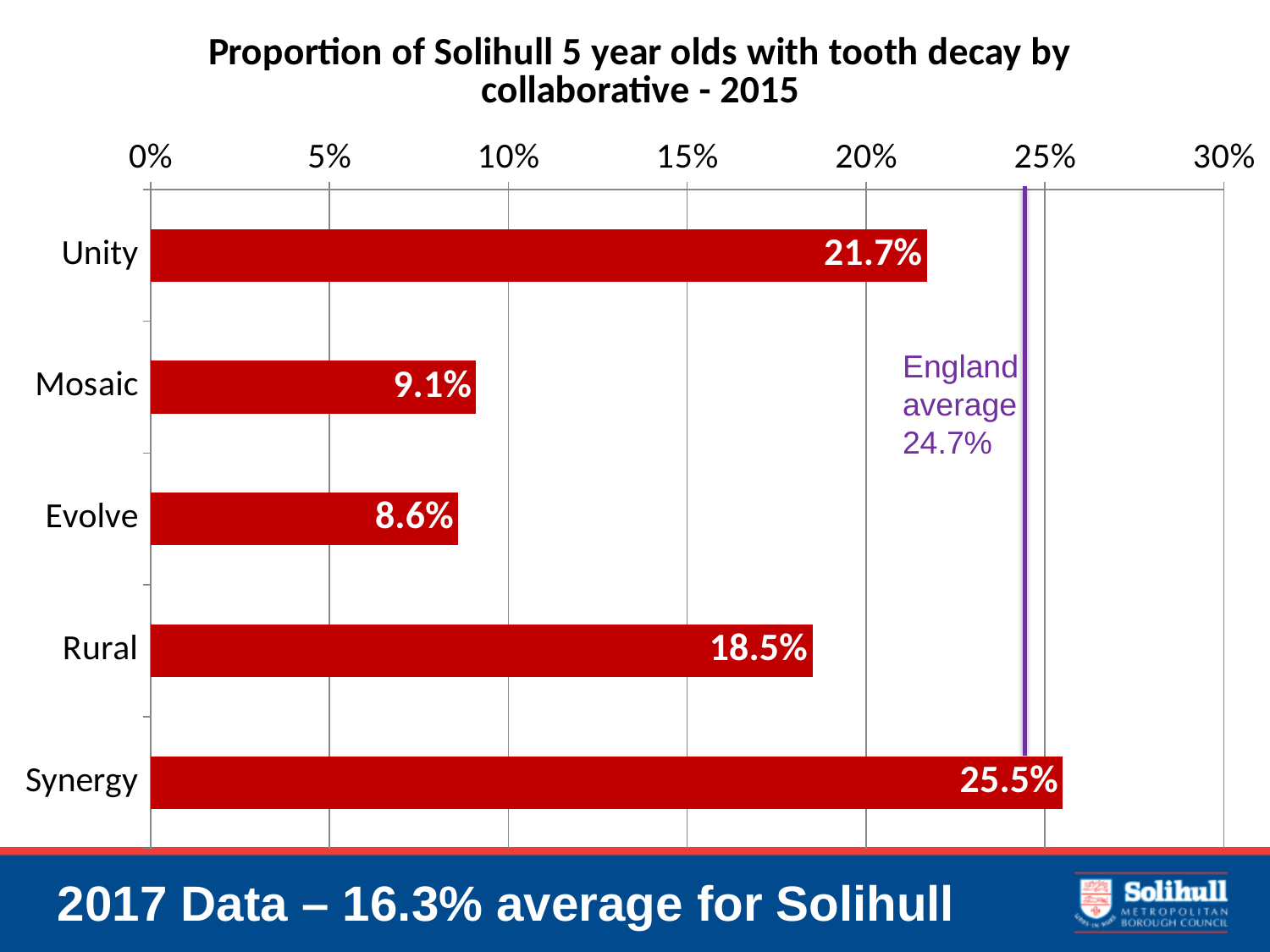
Which collaborative has the highest proportion of 5 year olds with tooth decay? Synergy Which has a higher proportion of 5 year olds with tooth decay, Rural or Mosaic? Rural What is the proportion of 5 year olds with tooth decay for Unity? 21.7% What England average value is marked by the vertical line on the chart? 24.7% What is the title of the chart? Proportion of Solihull 5 year olds with tooth decay by collaborative - 2015 Is the value for Unity greater or less than 20%? greater What is the proportion of 5 year olds with tooth decay for Mosaic? 9.1% Which collaborative has the lowest proportion of 5 year olds with tooth decay? Evolve How many collaboratives are shown on the chart? 5 What kind of chart is shown on the slide? Bar chart What is the difference between the proportions for Synergy and Unity? 3.8% What is the proportion of 5 year olds with tooth decay for Rural? 18.5%